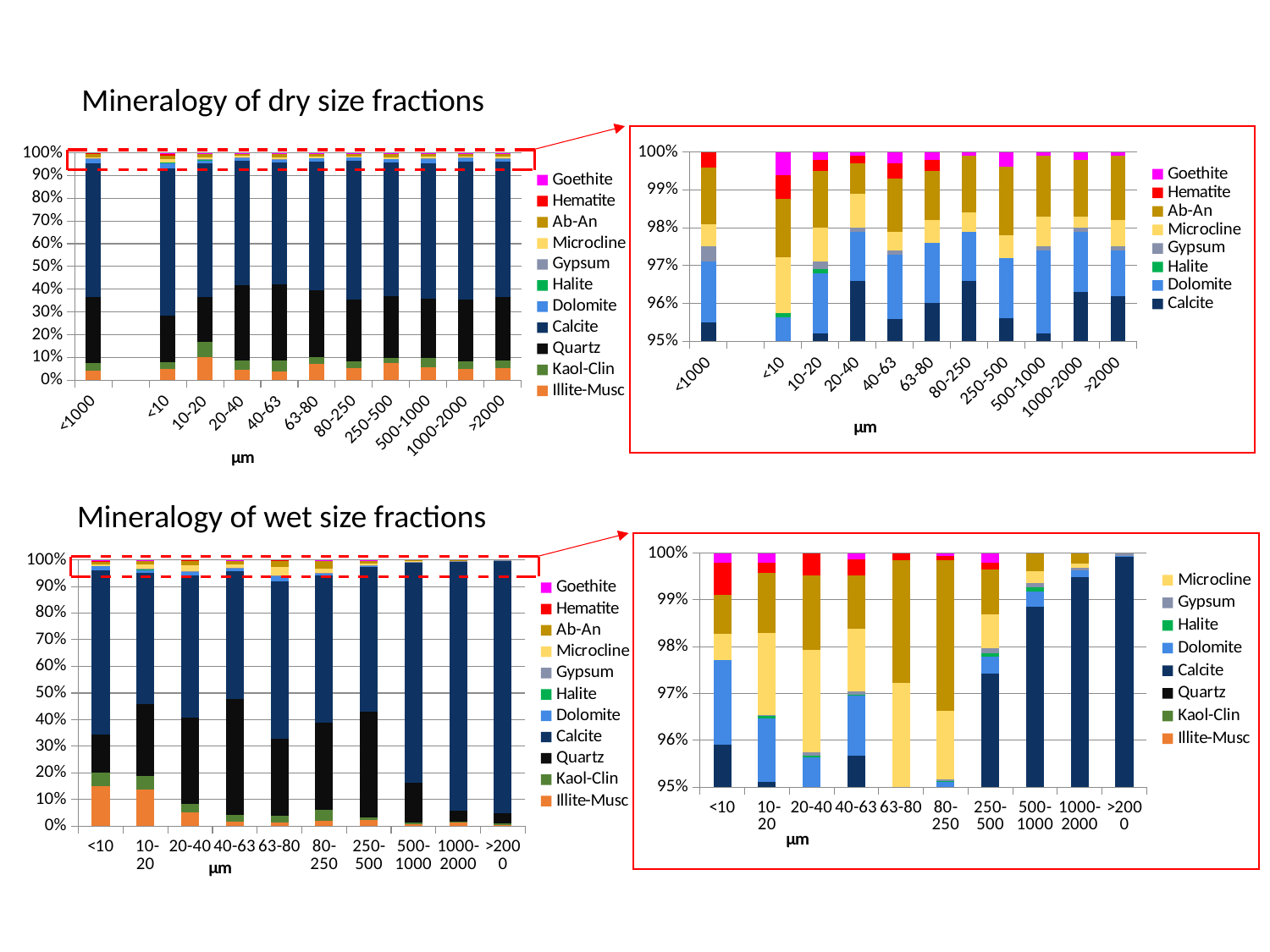
In the 'Mineralogy of wet size fractions' chart, is the top of the Quartz segment for the 63-80 fraction greater or less than 40%? less In the 'Mineralogy of wet size fractions' chart, which fraction has the larger Quartz segment, 40-63 or >2000? 40-63 What kind of chart is 'Mineralogy of dry size fractions'? Stacked bar chart In the 'Mineralogy of wet size fractions' chart, is the top of the Quartz segment for the 10-20 fraction greater or less than 40%? greater What range does the y axis cover in the two zoomed-in charts inside the red boxes? 95% to 100% How many series does the legend of the 'Mineralogy of wet size fractions' chart list? 11 In the 'Mineralogy of wet size fractions' chart, is the Illite-Musc share for the <10 fraction greater or less than 10%? greater How many series does the legend of the zoomed-in chart at the top right (red box) list? 8 How many size-fraction categories are shown on the x axis of the 'Mineralogy of wet size fractions' chart? 10 In the zoomed-in chart at the top right (dry fractions), which fraction has the higher top of the Calcite segment, <1000 or 80-250? 80-250 How many size-fraction categories are shown on the x axis of the 'Mineralogy of dry size fractions' chart? 11